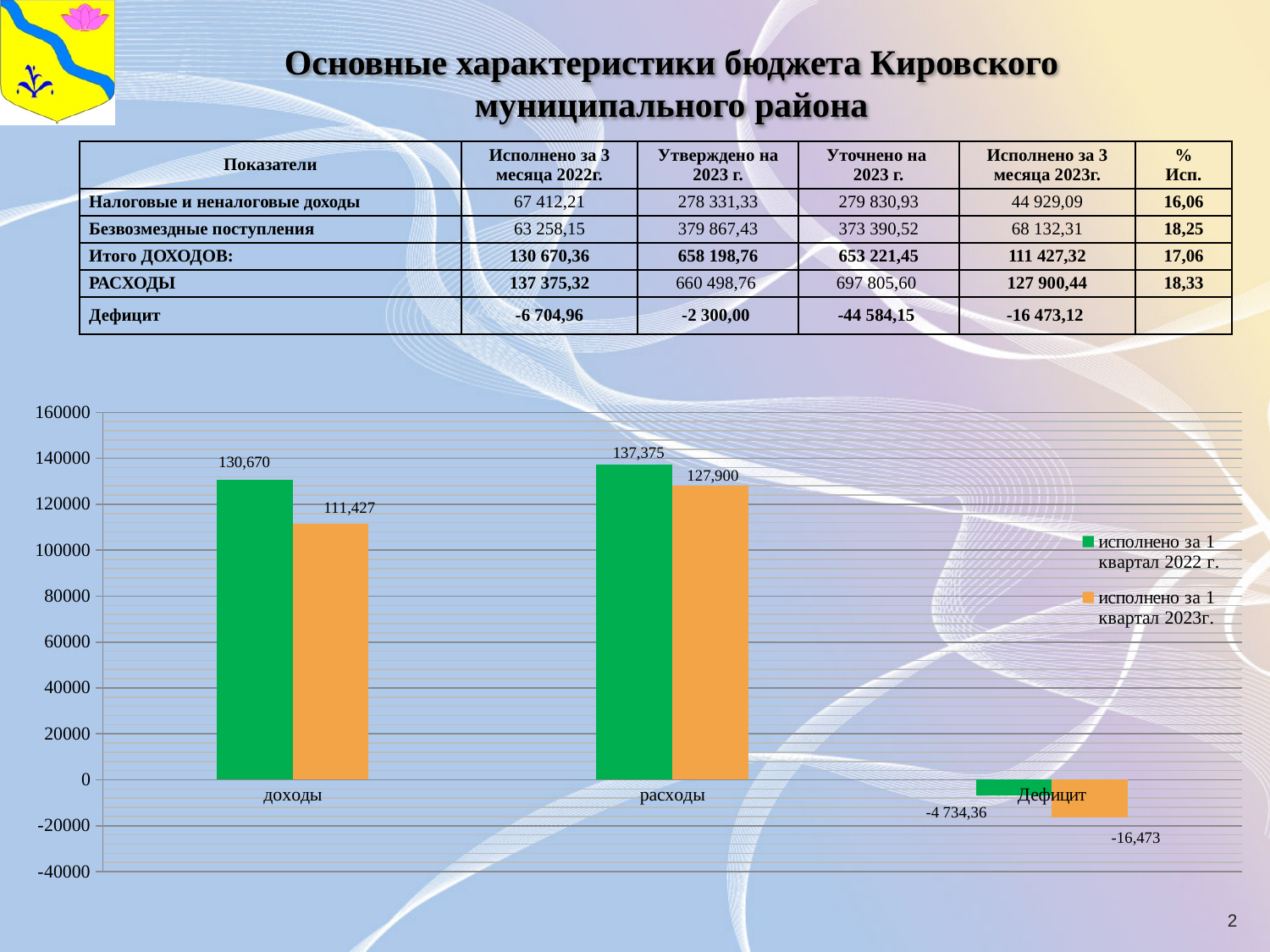
How many series does the chart legend list? 2 Which category has the lowest value in the series исполнено за 1 квартал 2023г.? Дефицит Is the value for расходы in the series исполнено за 1 квартал 2023г. greater or less than 120000? greater What is the value for расходы in the series исполнено за 1 квартал 2022 г.? 137,375 Which category has the highest value in the series исполнено за 1 квартал 2022 г.? расходы What is the value for Дефицит in the series исполнено за 1 квартал 2023г.? -16,473 Which is larger for доходы: the value for исполнено за 1 квартал 2022 г. or for исполнено за 1 квартал 2023г.? исполнено за 1 квартал 2022 г. What kind of chart is shown on the slide? bar chart What is the value for расходы in the series исполнено за 1 квартал 2023г.? 127,900 What is the value for доходы in the series исполнено за 1 квартал 2023г.? 111,427 What is the value for доходы in the series исполнено за 1 квартал 2022 г.? 130,670 How many categories are shown on the x axis of the chart? 3